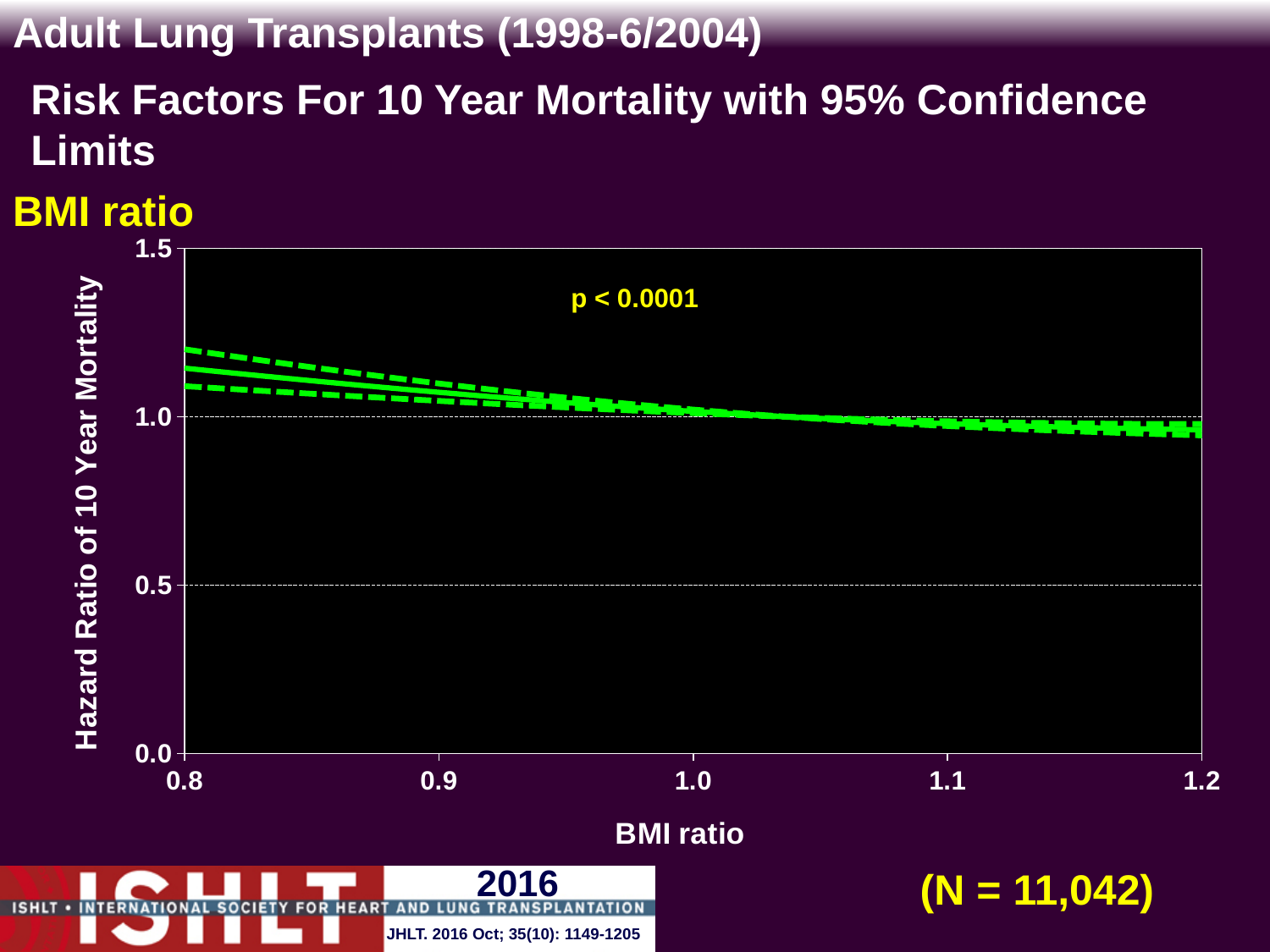
What is the label of the y axis? Hazard Ratio of 10 Year Mortality What kind of chart is shown on the slide? line chart Is the hazard ratio of 10 year mortality at a BMI ratio of 0.8 greater or less than 1.0? greater Does the hazard ratio of 10 year mortality rise or fall as BMI ratio increases from 0.8 to 1.2? fall What is the range of BMI ratio shown on the x axis? 0.8 to 1.2 Is the hazard ratio of 10 year mortality at a BMI ratio of 0.8 greater or less than 1.5? less What is the highest value shown on the y axis? 1.5 Is the hazard ratio of 10 year mortality at a BMI ratio of 1.0 greater or less than 0.5? greater What p-value is printed on the chart? p < 0.0001 What is the sample size (N) shown on the slide? N = 11,042 Which BMI ratio has the higher hazard ratio of 10 year mortality, 0.8 or 1.2? 0.8